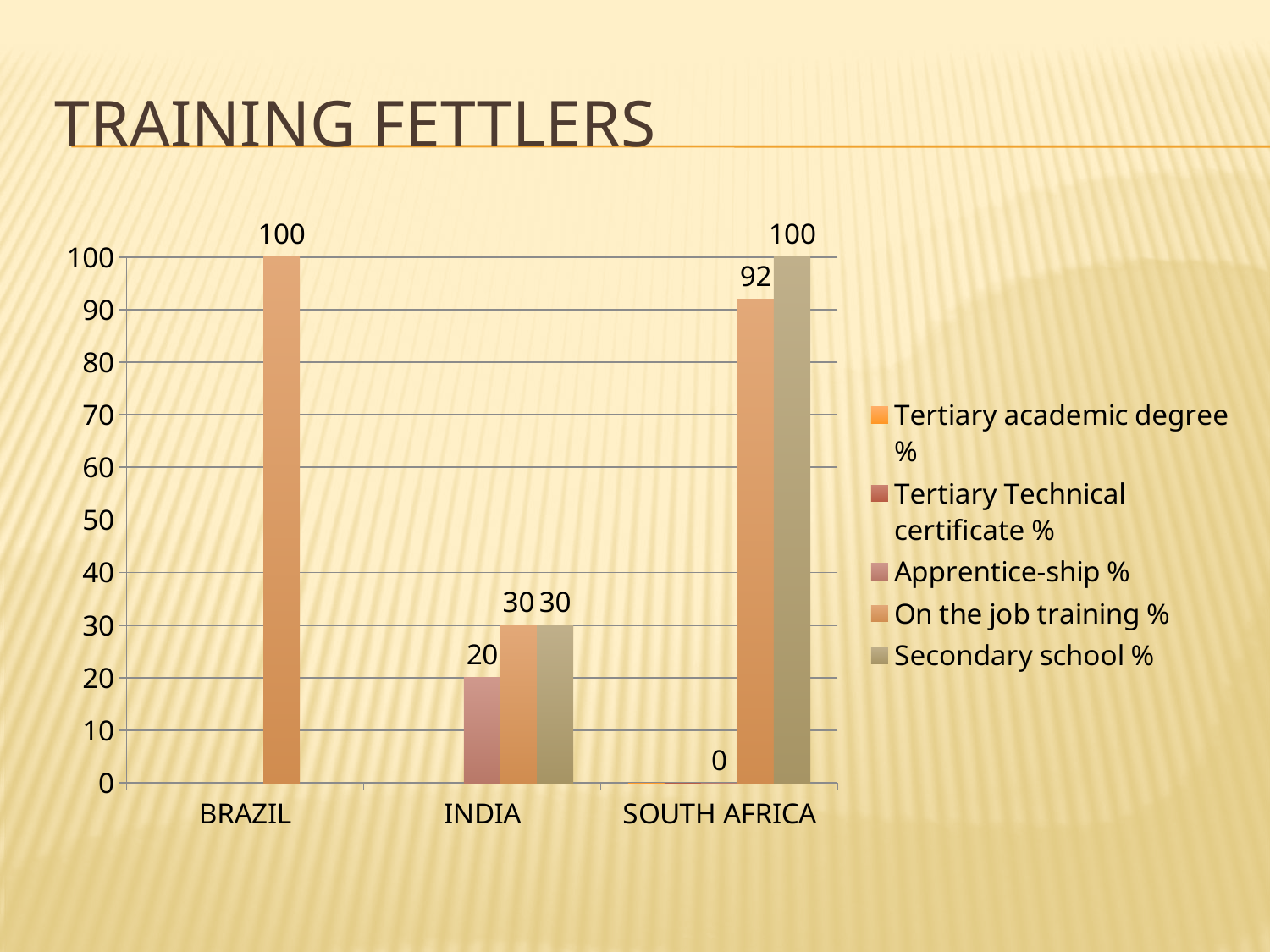
What is the Apprentice-ship % value for INDIA? 20 For INDIA, which is larger: On the job training % or Apprentice-ship %? On the job training % What is the On the job training % value for SOUTH AFRICA? 92 How many series does the legend list? 5 What is the difference between the Secondary school % and On the job training % values for SOUTH AFRICA? 8 What kind of chart is shown on the slide? Bar chart How many countries are shown on the x axis? 3 What is the Secondary school % value for SOUTH AFRICA? 100 Which country has the highest On the job training % value? BRAZIL What is the Secondary school % value for INDIA? 30 What is the difference between the On the job training % values for BRAZIL and INDIA? 70 What is the On the job training % value for BRAZIL? 100